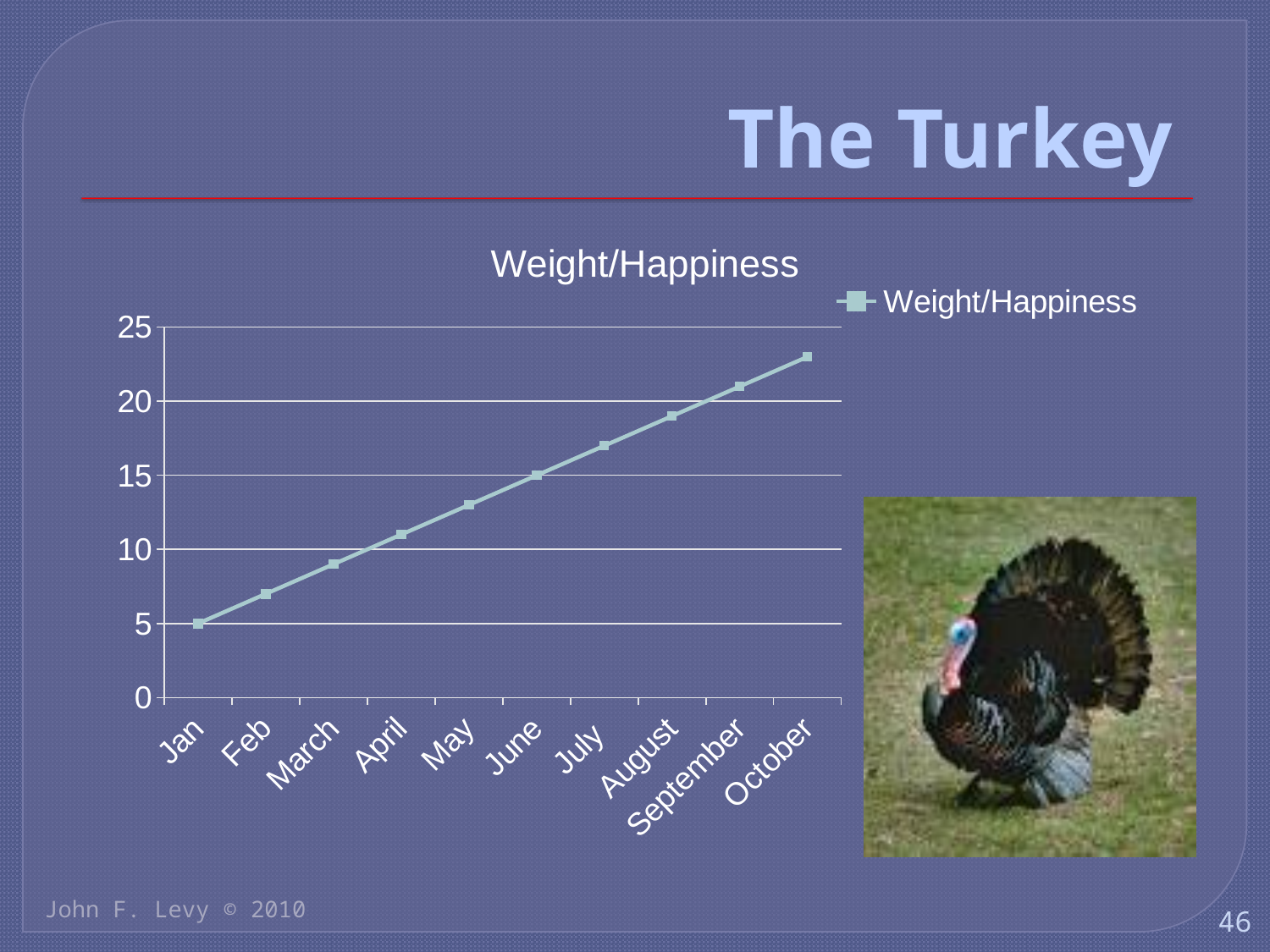
Is the value for October greater or less than 20? greater Is the value for March greater or less than 10? less How many series does the legend list? 1 What is the title of the chart? Weight/Happiness Which month has the larger Weight/Happiness value, April or August? August Which month has the highest Weight/Happiness value? October Which month has the lowest Weight/Happiness value? Jan How many months are plotted along the x axis? 10 What is the Weight/Happiness value for June? 15 What kind of chart is shown on the slide? line chart What is the Weight/Happiness value for Jan? 5 Do the Weight/Happiness values rise or fall from Jan to October? rise